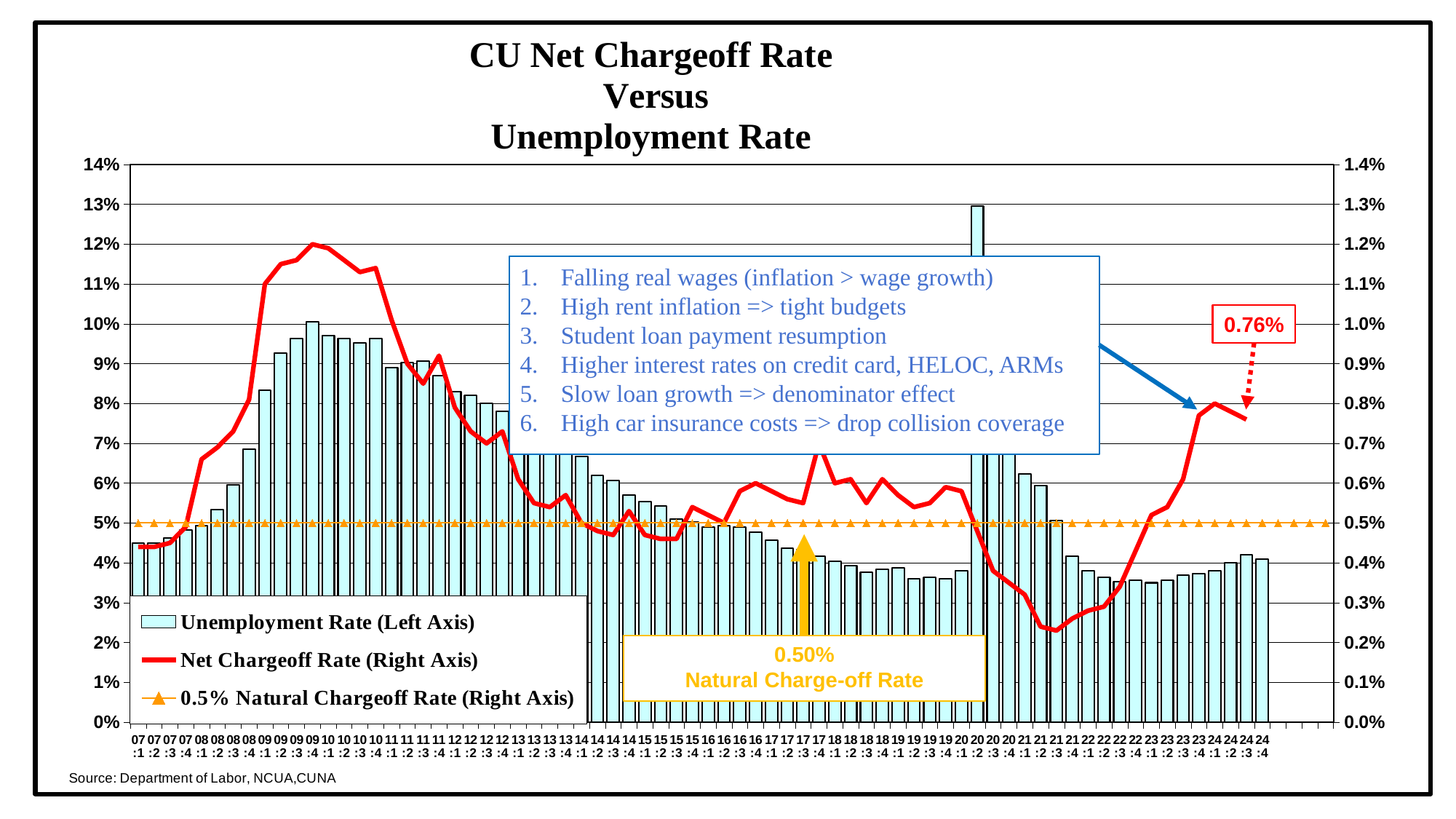
Which is larger, the Unemployment Rate for 20:2 or for 09:4? 20:2 What value is labeled for the Net Chargeoff Rate at the end of the series (24:4)? 0.76% Is the Unemployment Rate for 20:2 greater or less than 12%? greater What is the title of the chart? CU Net Chargeoff Rate Versus Unemployment Rate How many series does the chart's legend list? 3 Is the Net Chargeoff Rate for 09:4 greater or less than 1.1%? greater Is the Unemployment Rate for 09:4 greater or less than 9%? greater What kind of chart is this? Combined bar and line chart What is the value of the Natural Charge-off Rate line? 0.50% Which quarter has the highest Unemployment Rate bar? 20:2 Does the Net Chargeoff Rate rise or fall from 22:3 to 24:1? rise